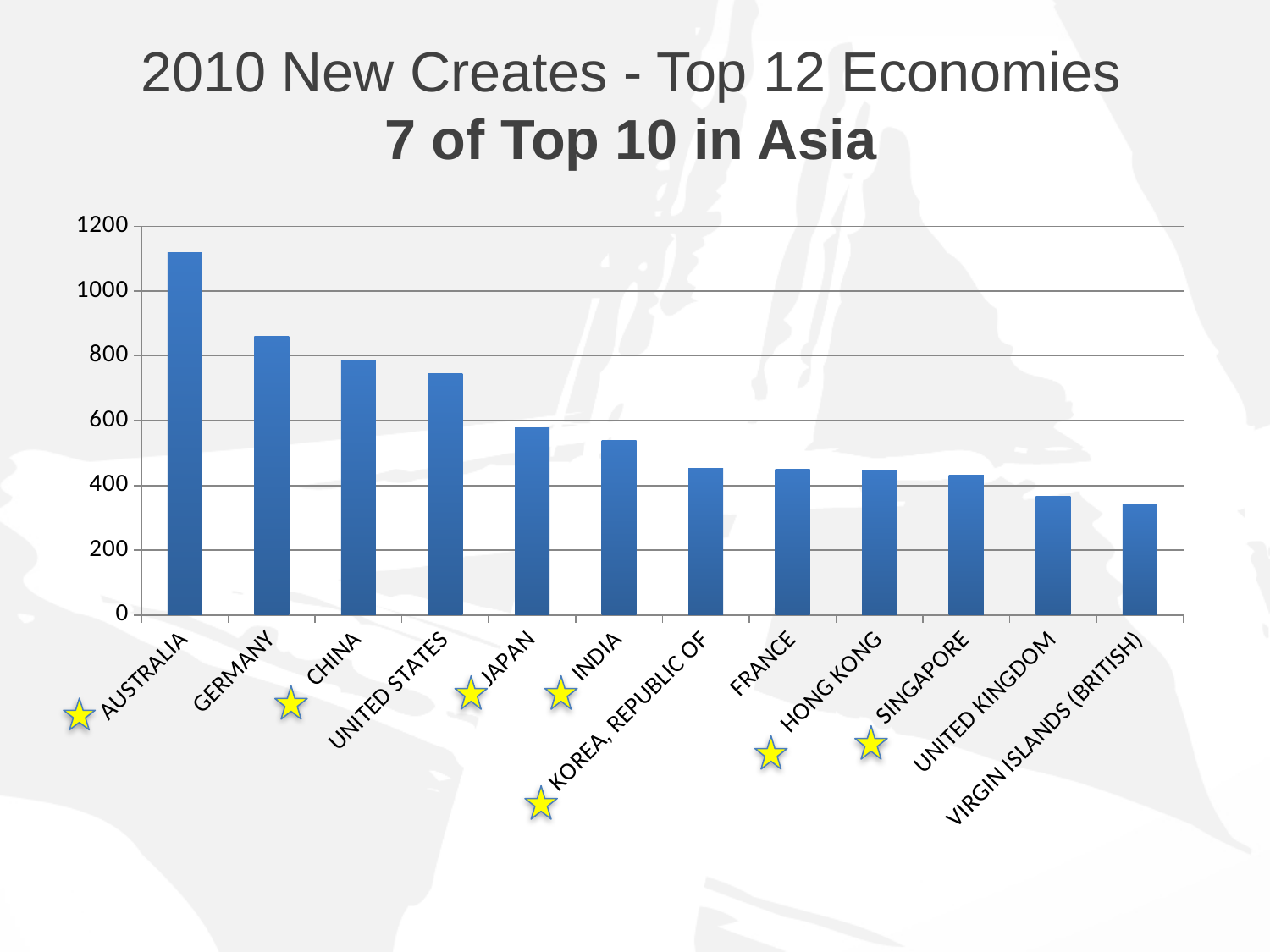
Is the value for Australia greater or less than 1000? greater Which has the larger value, Japan or India? Japan Which economy has the lowest bar in the chart? Virgin Islands (British) Do the bar values rise or fall moving from left to right along the x axis? Fall What kind of chart is shown on the slide? Bar chart Is the value for India greater or less than 400? greater Is the value for Germany greater or less than 800? greater Which economy has the highest bar in the chart? Australia How many economies are shown on the x axis of the chart? 12 What is the title of the slide containing the chart? 2010 New Creates - Top 12 Economies 7 of Top 10 in Asia